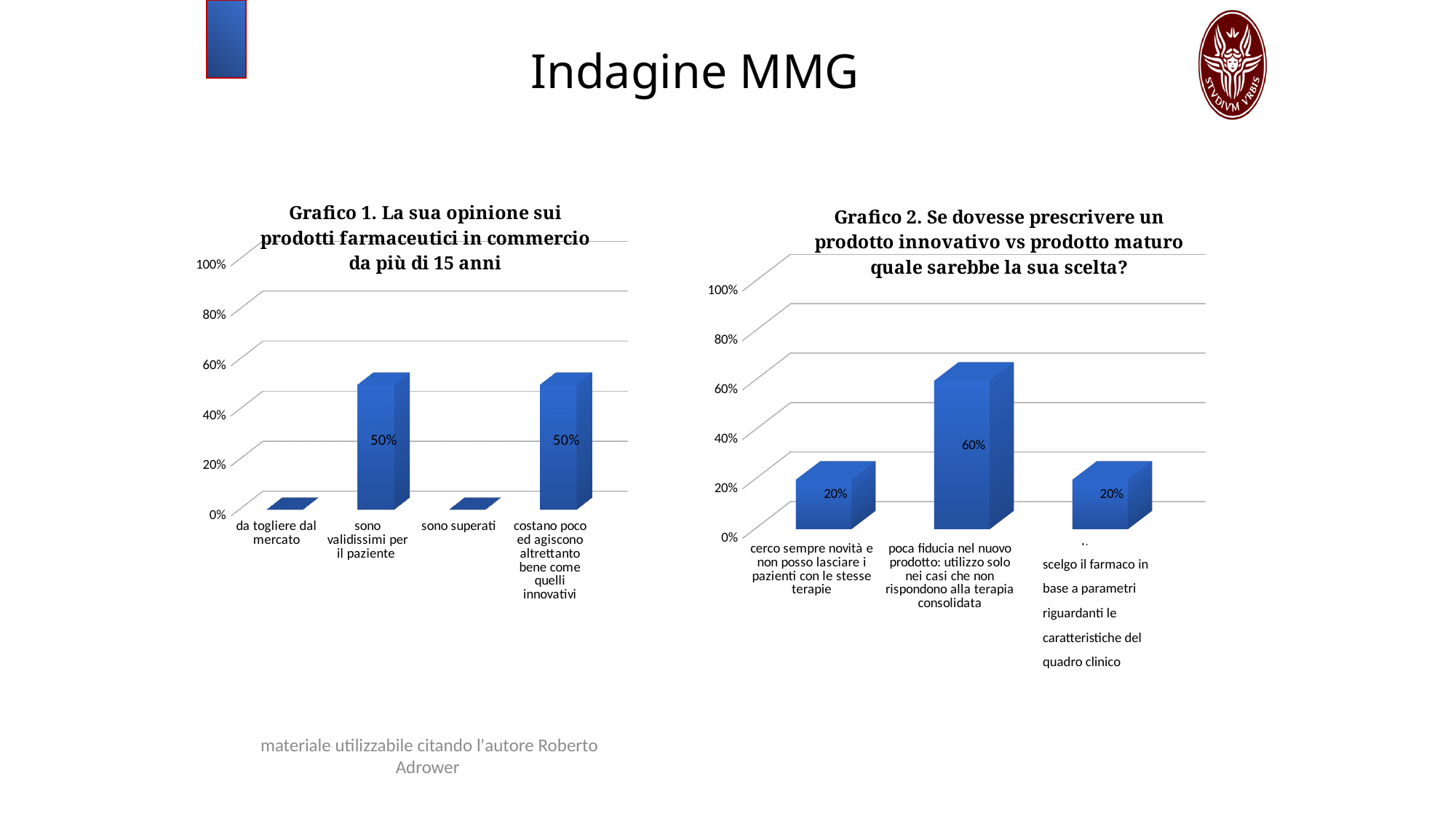
In Grafico 2, what is the value for "cerco sempre novità e non posso lasciare i pazienti con le stesse terapie"? 20% In Grafico 2, how many categories are shown? 3 In Grafico 2, what is the difference between the value for "poca fiducia nel nuovo prodotto" and the value for "cerco sempre novità"? 40% In Grafico 2, what is the value for "poca fiducia nel nuovo prodotto: utilizzo solo nei casi che non rispondono alla terapia consolidata"? 60% In Grafico 2, which category has the highest value? poca fiducia nel nuovo prodotto: utilizzo solo nei casi che non rispondono alla terapia consolidata In Grafico 1, how many categories are shown on the x axis? 4 In Grafico 1, what is the value for "costano poco ed agiscono altrettanto bene come quelli innovativi"? 50% In Grafico 1, is the value for "da togliere dal mercato" greater or less than 20%? less What kind of chart is Grafico 2? bar chart What is the title of the chart on the left of the slide? Grafico 1. La sua opinione sui prodotti farmaceutici in commercio da più di 15 anni In Grafico 2, which is larger: the value for "poca fiducia nel nuovo prodotto" or the value for "scelgo il farmaco in base a parametri riguardanti le caratteristiche del quadro clinico"? poca fiducia nel nuovo prodotto In Grafico 1, what is the value for "sono validissimi per il paziente"? 50%